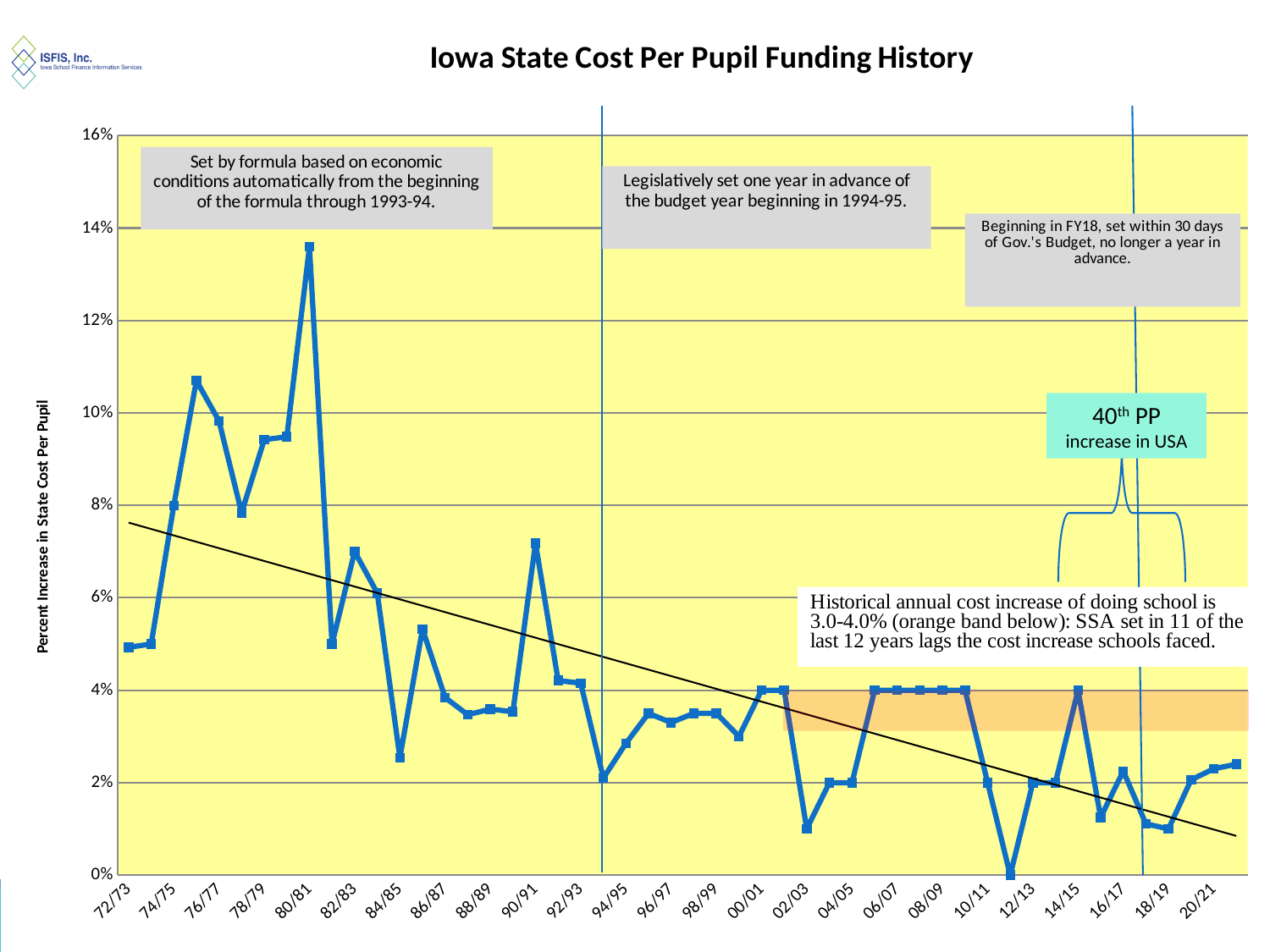
What is the title of the chart? Iowa State Cost Per Pupil Funding History Is the value for 75/76 greater or less than 10%? greater What is the percent increase for 06/07? 4% Which year has the lowest percent increase in state cost per pupil? 11/12 Overall, do the values rise or fall from 72/73 to 21/22? fall Which year has a larger percent increase, 80/81 or 90/91? 80/81 What type of chart is shown on the slide? line chart Is the value for 02/03 greater or less than 2%? less What is the percent increase for 11/12? 0% What is the label on the vertical axis of the chart? Percent Increase in State Cost Per Pupil Which year has the highest percent increase in state cost per pupil? 80/81 Is the value for 93/94 greater or less than 4%? less